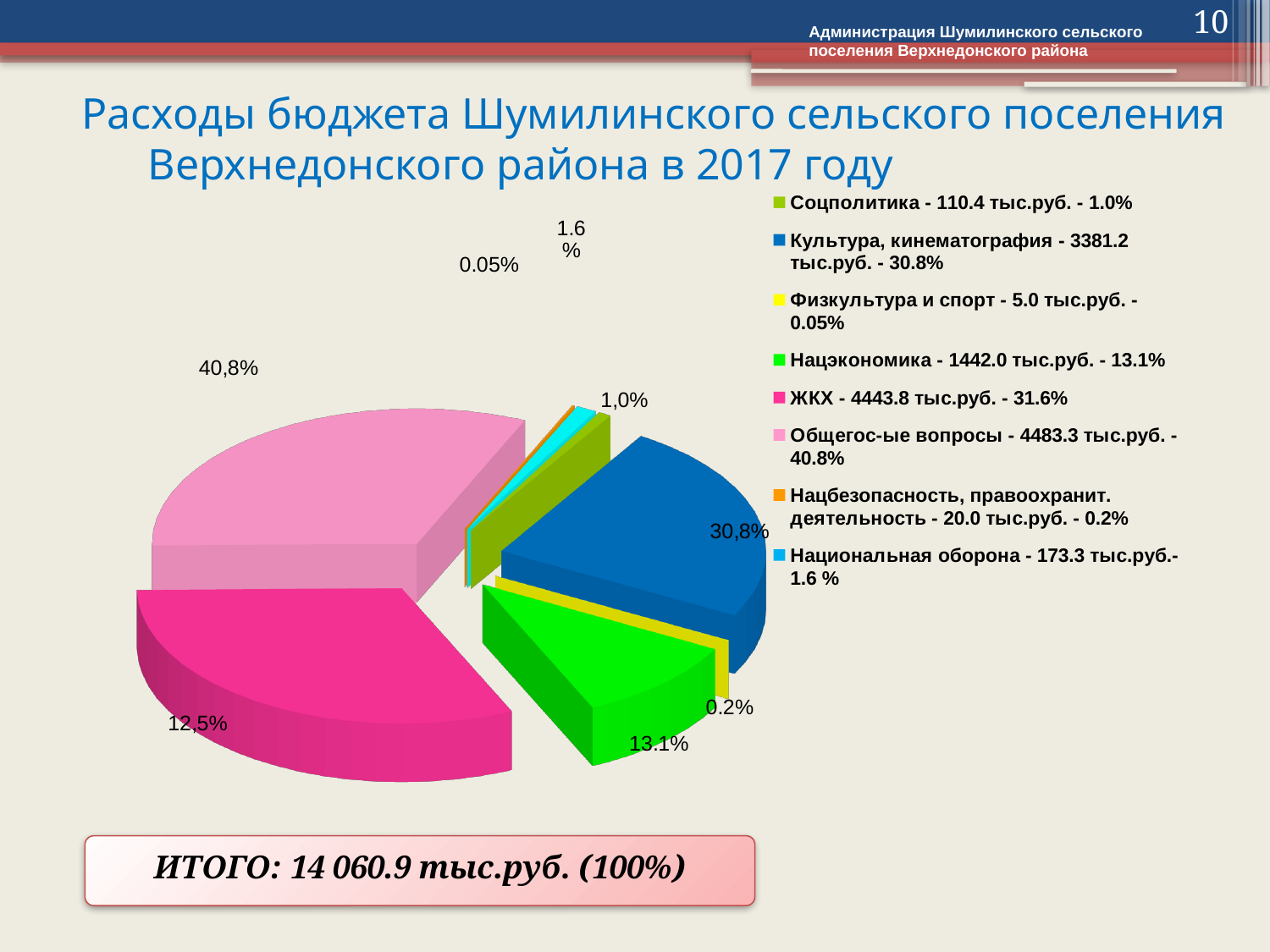
Which category has the largest share of the pie? Общегос-ые вопросы Which is larger, the amount for Нацэкономика or the amount for Соцполитика? Нацэкономика What share of the budget does Нацэкономика account for? 13.1% What is the amount for Культура, кинематография according to the legend? 3381.2 тыс.руб. What is the amount for Национальная оборона according to the legend? 173.3 тыс.руб. Which category has the smallest share of the pie? Физкультура и спорт What kind of chart is shown on the slide? pie chart What colour is the slice for Культура, кинематография? blue How many categories does the legend of the pie chart list? 8 What total amount (ИТОГО) is shown below the chart? 14 060.9 тыс.руб. (100%) What is the difference between the amounts for Общегос-ые вопросы and Культура, кинематография? 1102.1 тыс.руб. What share of the budget does Нацбезопасность, правоохранит. деятельность account for? 0.2%